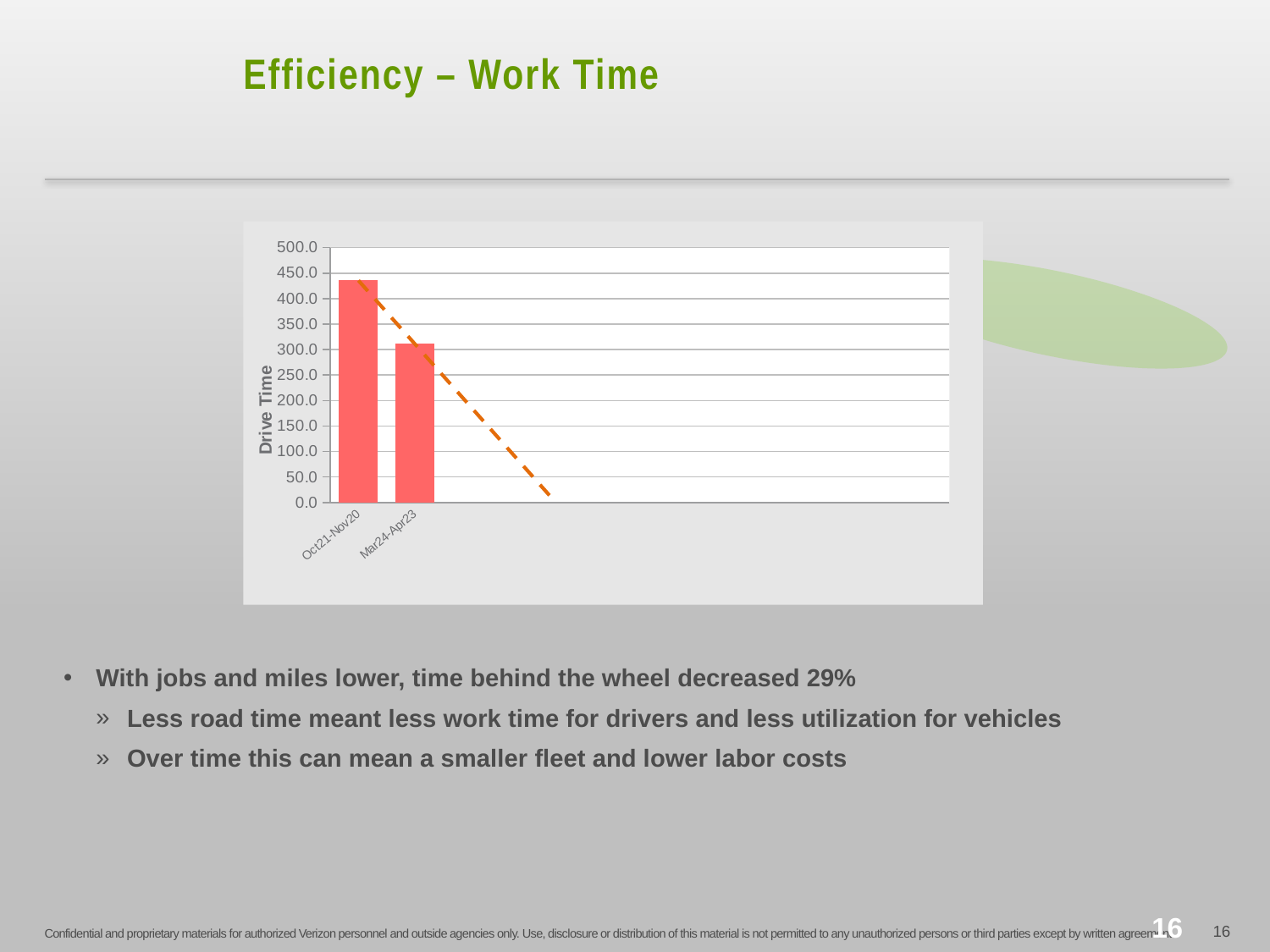
What is the highest value shown on the vertical axis of the chart? 500.0 Is the Drive Time value for Mar24-Apr23 greater or less than 250.0? greater Which category has the lowest Drive Time value? Mar24-Apr23 How many categories are plotted on the x axis of the chart? 2 Is the Drive Time value for Oct21-Nov20 greater or less than 450.0? less What is the label on the vertical axis of the chart? Drive Time Do the bar values rise or fall from Oct21-Nov20 to Mar24-Apr23? fall Is the Drive Time value for Mar24-Apr23 greater or less than 350.0? less Which category has the highest Drive Time value? Oct21-Nov20 Which is larger, the Drive Time for Oct21-Nov20 or for Mar24-Apr23? Oct21-Nov20 What kind of chart is shown on the slide? bar chart